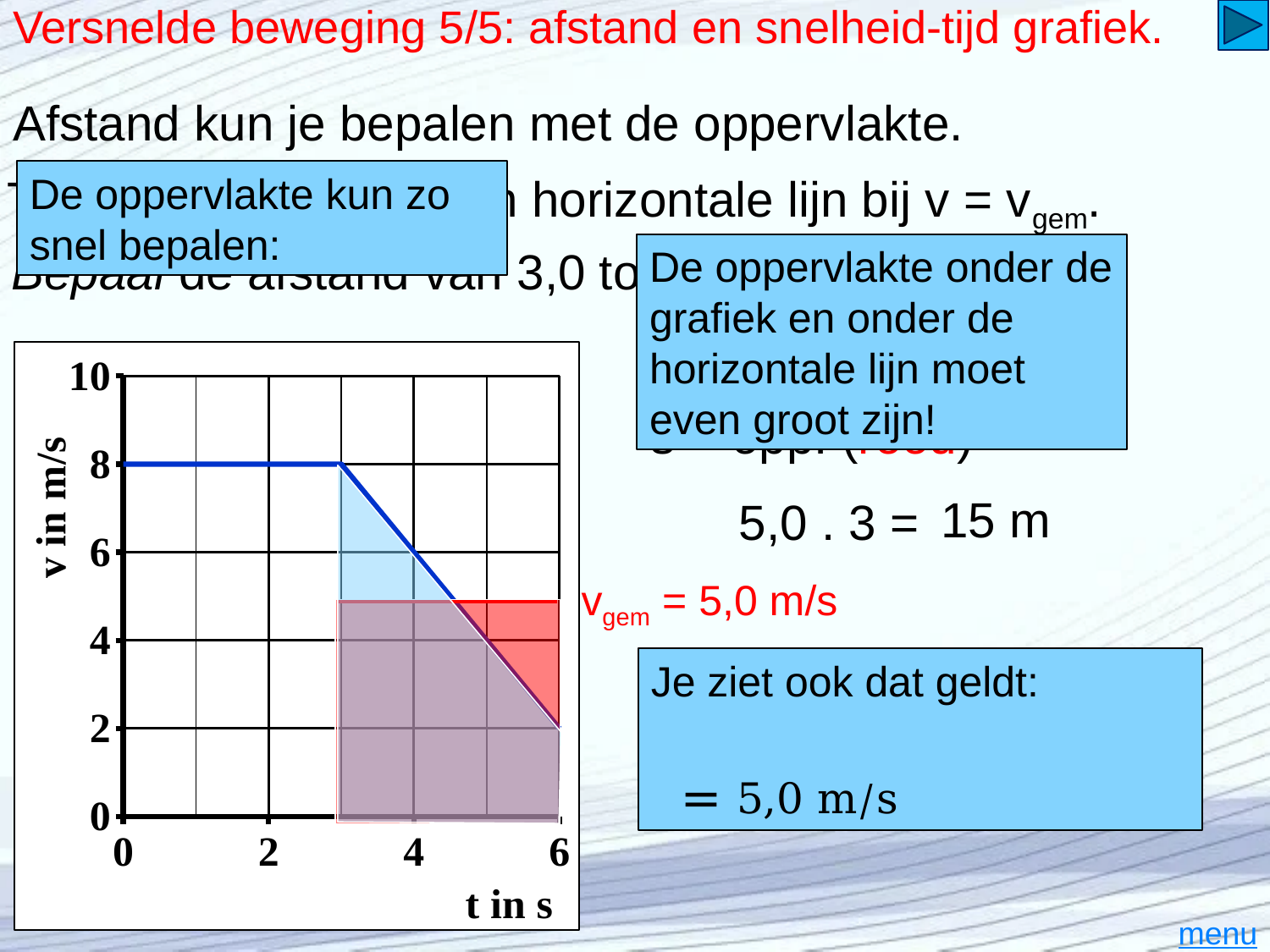
What is the value of v at t = 0 s? 8 m/s Does v rise, fall or stay constant between t = 3 s and t = 6 s? fall What kind of chart is shown on the slide? line chart What is the label of the horizontal axis of the chart? t in s What is the value of v at t = 6 s? 2 m/s Is the value of v at t = 5 s greater or less than 6? less What is the highest value of v shown on the graph? 8 m/s Which is larger, v at t = 2 s or v at t = 5 s? v at t = 2 s What is the difference between v at t = 0 s and v at t = 6 s? 6 m/s What is the lowest value of v shown on the graph? 2 m/s What is the label of the vertical axis of the chart? v in m/s What is the value of v at t = 3 s? 8 m/s